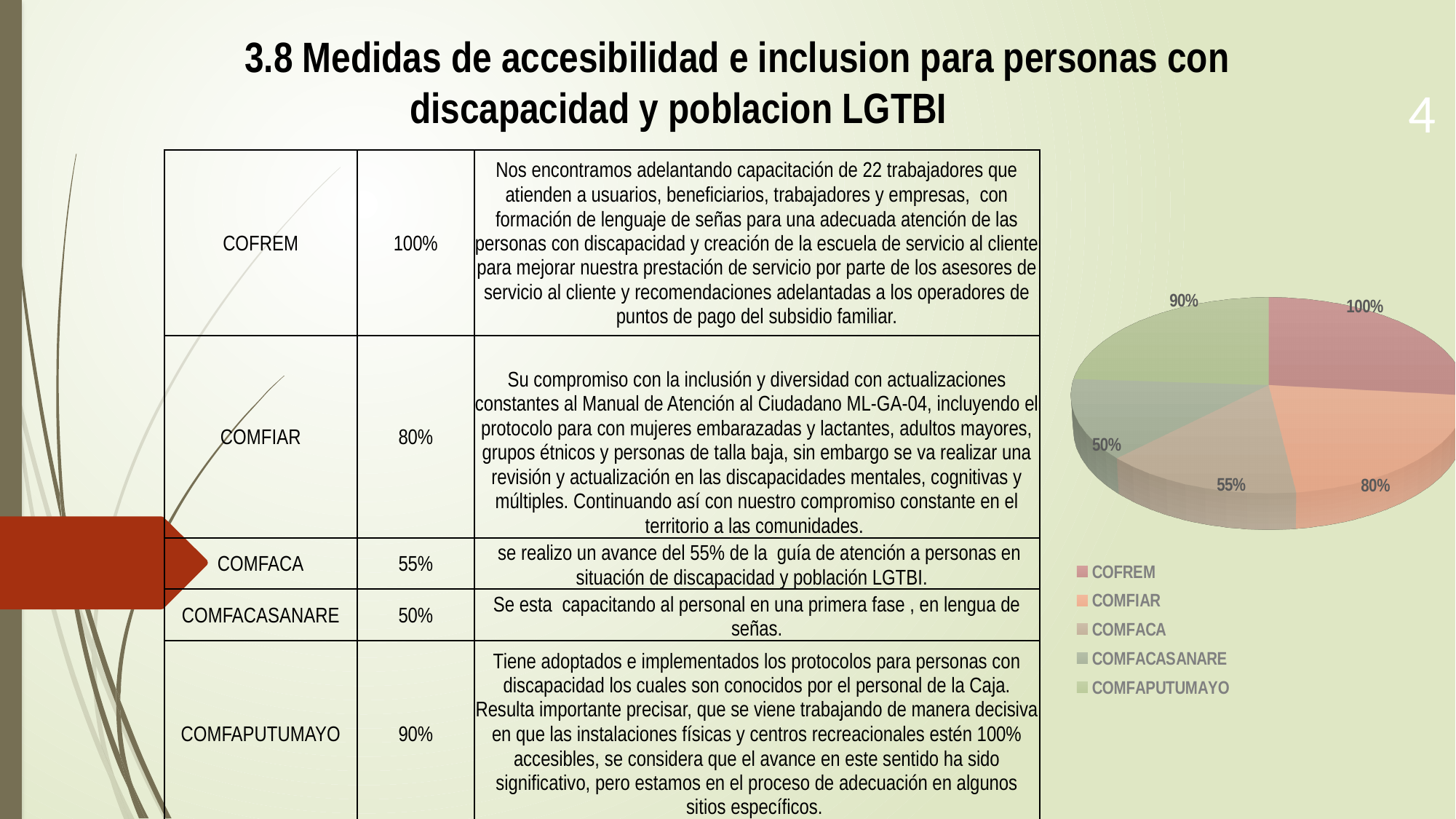
What value is shown for COFREM in the pie chart? 100% Which has a larger value in the pie chart, COMFIAR or COMFAPUTUMAYO? COMFAPUTUMAYO What is the difference between the values for COFREM and COMFACASANARE in the pie chart? 50% Which category has the lowest value in the pie chart? COMFACASANARE What value is shown for COMFAPUTUMAYO in the pie chart? 90% What kind of chart is shown on the slide? pie chart Which category has the highest value in the pie chart? COFREM What value is shown for COMFACASANARE in the pie chart? 50% How many entries does the pie chart's legend list? 5 What value is shown for COMFIAR in the pie chart? 80% Which legend entry is listed first in the pie chart's legend? COFREM How many slices does the pie chart have? 5